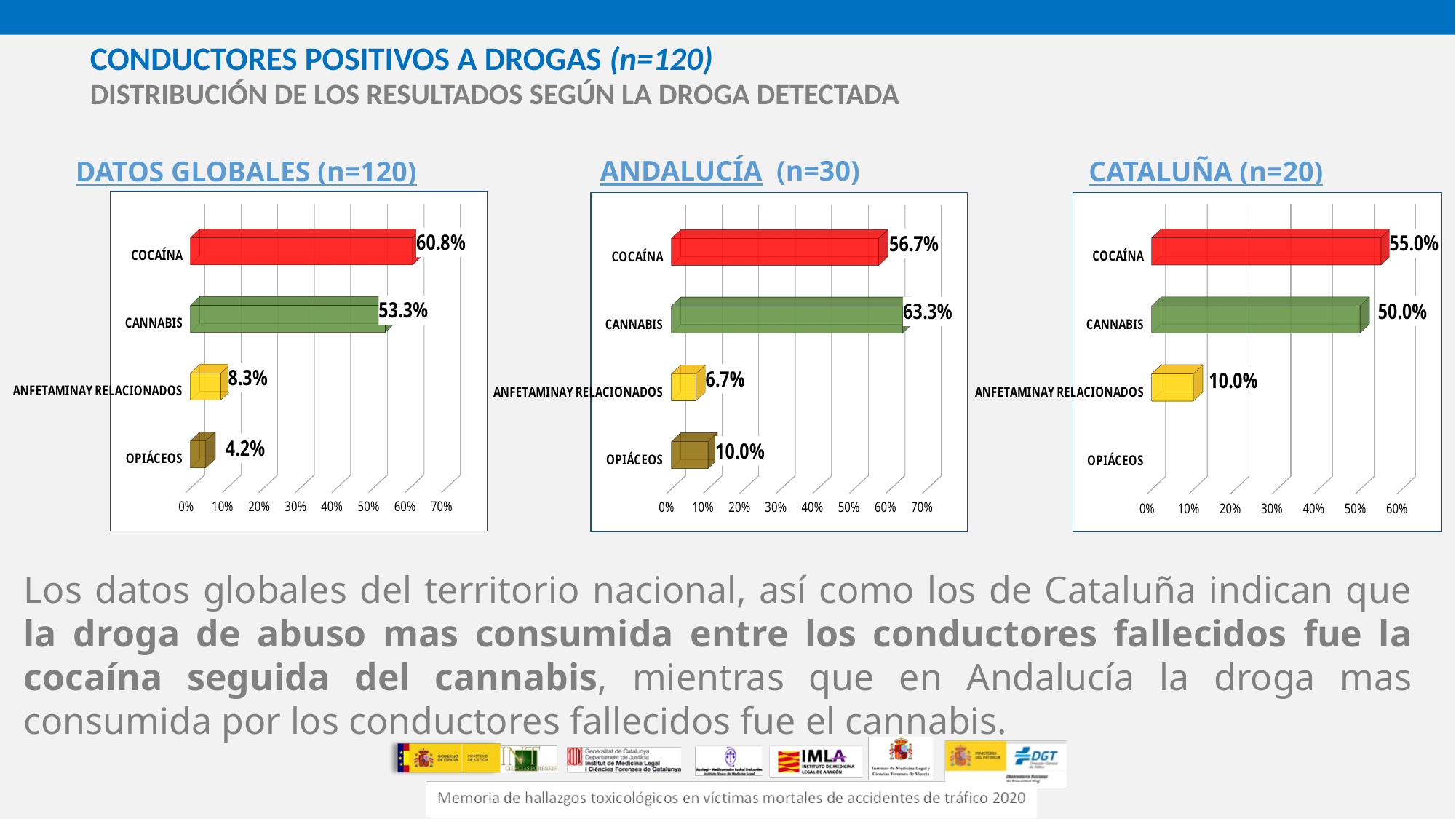
In the ANDALUCÍA (n=30) chart, which category has the highest value? CANNABIS In the DATOS GLOBALES (n=120) chart, what is the difference between the COCAÍNA and CANNABIS values? 7.5% What colour is the COCAÍNA bar in the CATALUÑA (n=20) chart? red What kind of chart is the ANDALUCÍA (n=30) chart? bar chart In the CATALUÑA (n=20) chart, what is the value for ANFETAMINA Y RELACIONADOS? 10.0% How many categories are shown on the y axis of the DATOS GLOBALES (n=120) chart? 4 In the ANDALUCÍA (n=30) chart, what is the value for CANNABIS? 63.3% In the DATOS GLOBALES (n=120) chart, what is the value for COCAÍNA? 60.8% In the CATALUÑA (n=20) chart, which is larger, COCAÍNA or CANNABIS? COCAÍNA In the DATOS GLOBALES (n=120) chart, which category has the lowest value? OPIÁCEOS In the ANDALUCÍA (n=30) chart, what is the value for OPIÁCEOS? 10.0% In the ANDALUCÍA (n=30) chart, is the value for COCAÍNA greater or less than 50%? greater